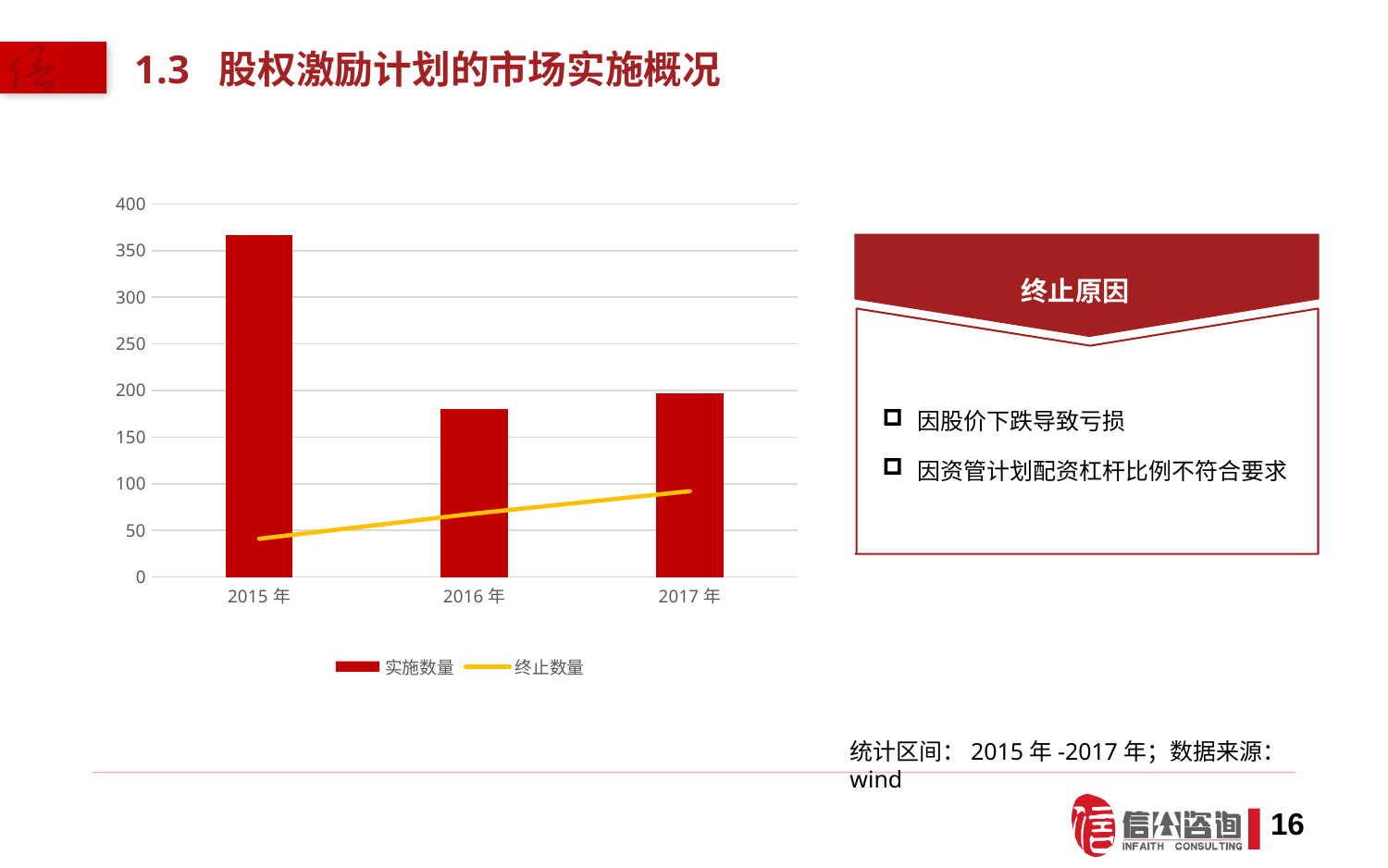
Which series is drawn as a yellow line in the chart? 终止数量 How many series does the chart legend list? 2 What kind of chart is shown on the slide? A combined bar and line chart Does the 终止数量 line rise or fall from 2015年 to 2017年? Rises Which year has the highest 实施数量 bar? 2015年 Is the 实施数量 value for 2015年 greater or less than 300? greater Which year has the lowest 实施数量 bar? 2016年 Which is larger, the 实施数量 for 2015年 or for 2017年? 2015年 Is the 实施数量 value for 2016年 greater or less than 200? less Is the 终止数量 value for 2017年 greater or less than 100? less How many years are shown on the x axis of the chart? 3